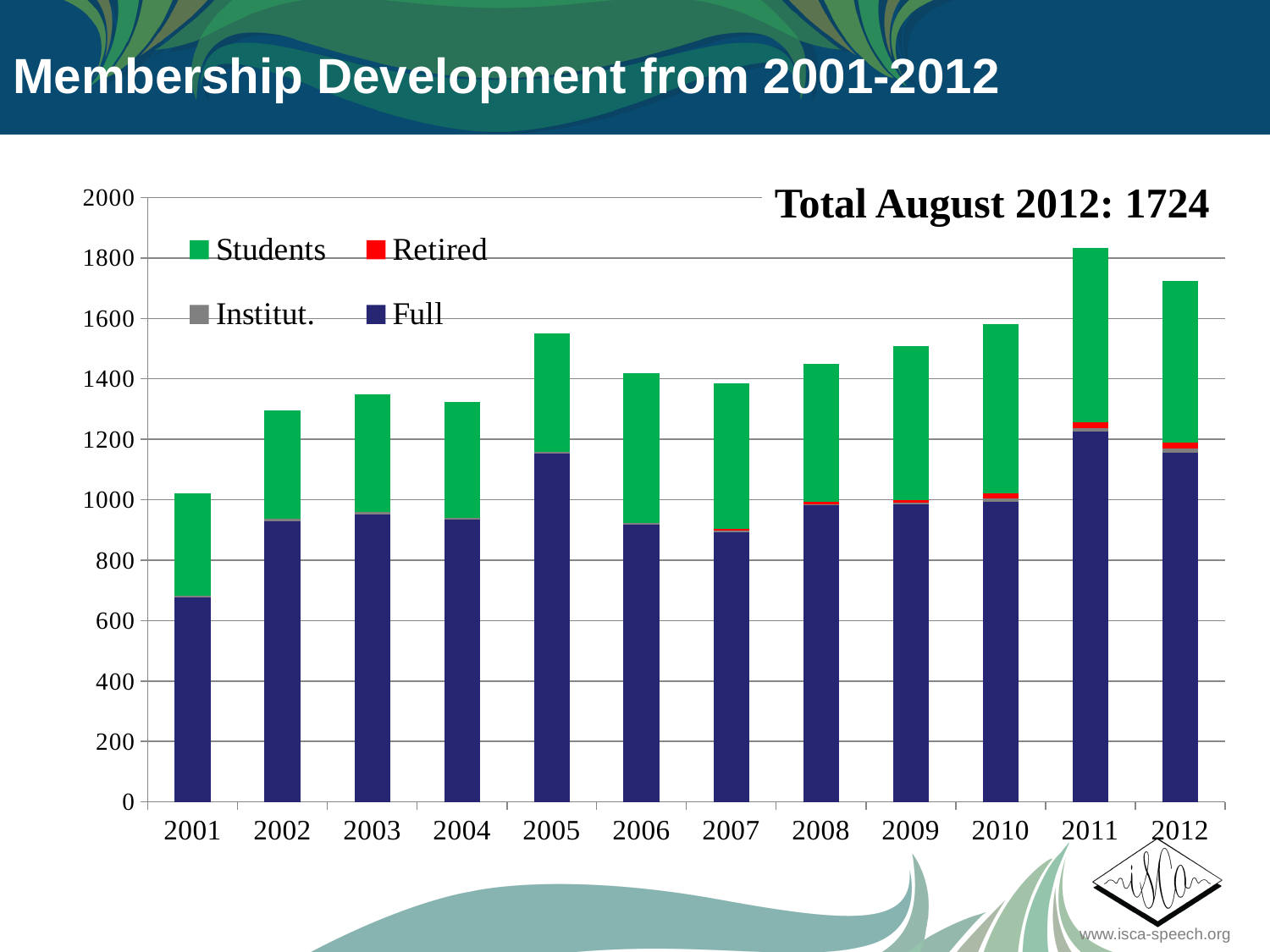
What kind of chart is shown on the slide? Stacked bar chart Which series is shown in green in the chart? Students Is the Full segment for 2012 greater or less than 1000? greater Do the total bars rise or fall from 2007 to 2011? rise What total membership is stated on the slide for August 2012? 1724 Which year has the shortest total bar in the chart? 2001 How many years are shown along the x axis of the chart? 12 How many series does the chart's legend list? 4 Is the Full segment for 2001 greater or less than 800? less Is the total bar for 2005 greater or less than 1400? greater Which year has the taller total bar, 2004 or 2005? 2005 Which year has the tallest total bar in the chart? 2011